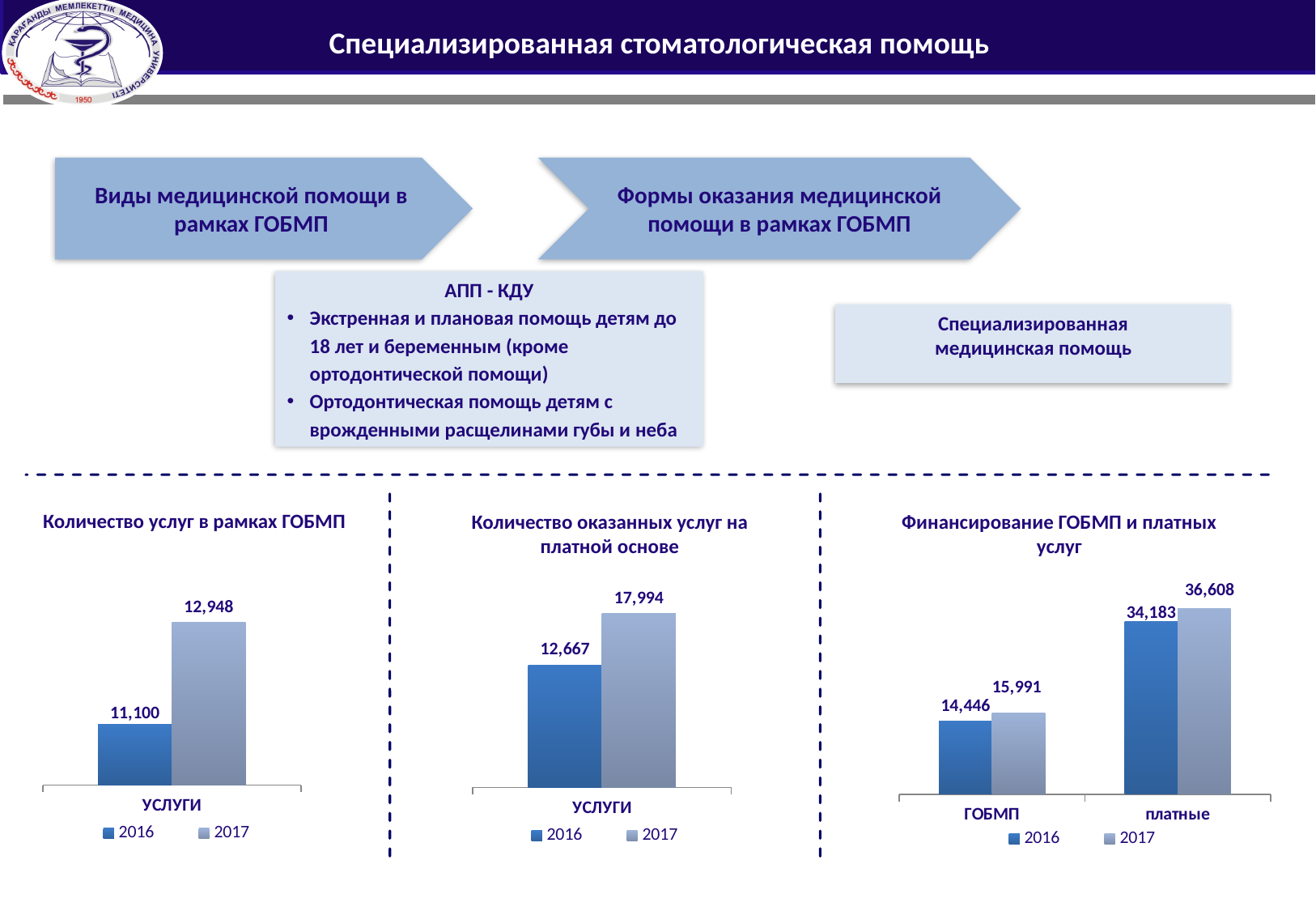
How many series does the legend list in the chart 'Финансирование ГОБМП и платных услуг'? 2 In the chart 'Количество оказанных услуг на платной основе', what is the value for 2016? 12,667 In the chart 'Количество оказанных услуг на платной основе', what is the value for 2017? 17,994 In the chart 'Финансирование ГОБМП и платных услуг', what is the 2016 value for ГОБМП? 14,446 In the chart 'Финансирование ГОБМП и платных услуг', what is the 2017 value for платные? 36,608 In the chart 'Количество оказанных услуг на платной основе', which year has the larger value, 2016 or 2017? 2017 What type of chart is 'Количество услуг в рамках ГОБМП'? Bar chart In the chart 'Количество услуг в рамках ГОБМП', what is the value for 2017? 12,948 In the chart 'Финансирование ГОБМП и платных услуг', what is the difference between the 2017 and 2016 values for ГОБМП? 1,545 In the chart 'Количество услуг в рамках ГОБМП', what is the difference between the 2017 and 2016 values? 1,848 In the chart 'Финансирование ГОБМП и платных услуг', which category has the highest value in 2017? платные In the chart 'Количество услуг в рамках ГОБМП', what is the value for 2016? 11,100